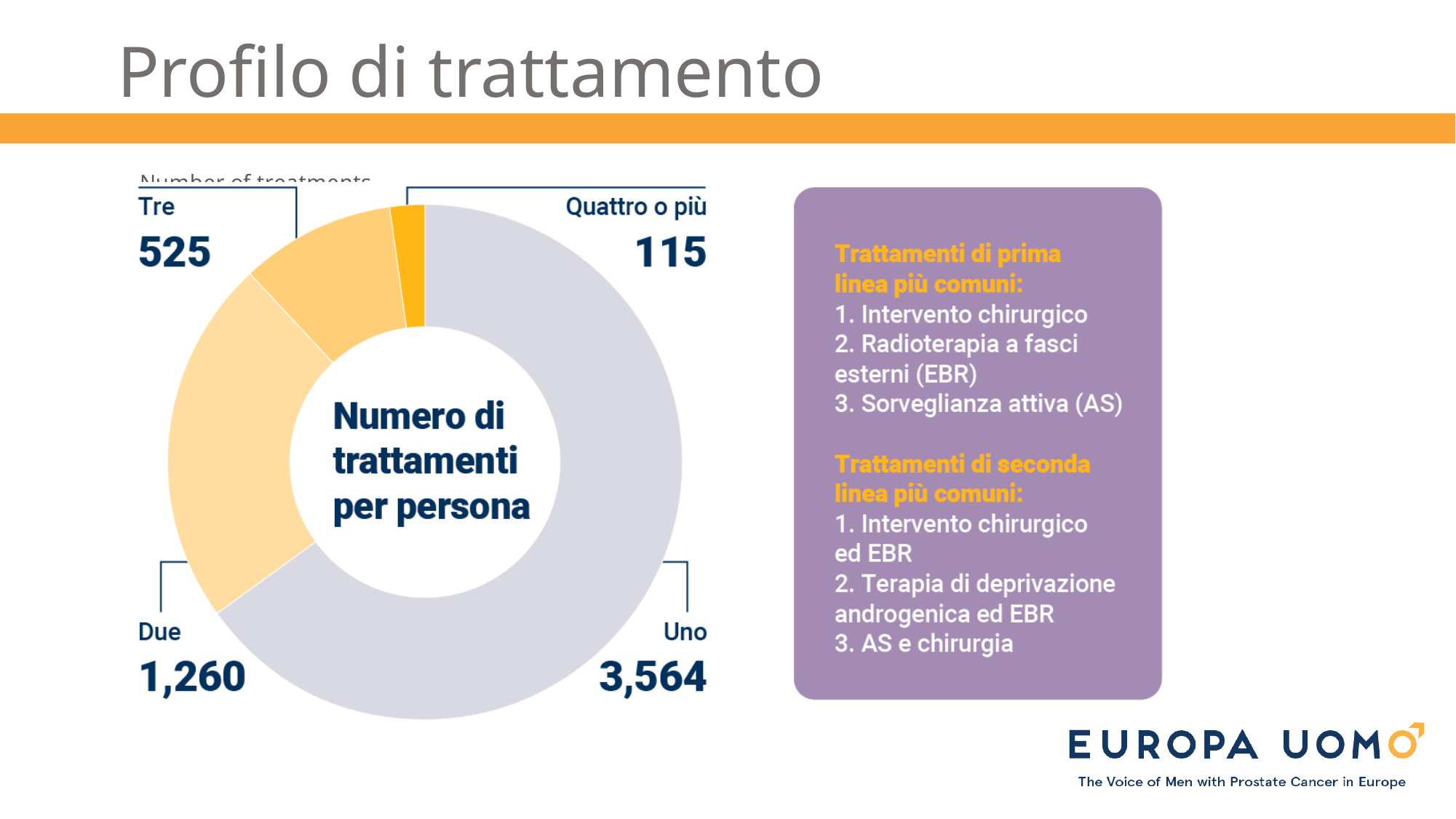
What is the difference between the values for "Uno" and "Due"? 2,304 What is the value for the "Tre" segment of the donut chart? 525 What kind of chart is shown on the slide? Pie (donut) chart Which category has the highest value in the donut chart? Uno What is the value for the "Quattro o più" segment of the donut chart? 115 What is the value for the "Uno" segment of the donut chart? 3,564 What is the value for the "Due" segment of the donut chart? 1,260 Which is larger, the value for "Tre" or the value for "Quattro o più"? Tre Which category has the lowest value in the donut chart? Quattro o più What text is written in the centre of the donut chart? Numero di trattamenti per persona What is the difference between the values for "Due" and "Tre"? 735 How many categories are shown in the donut chart? 4